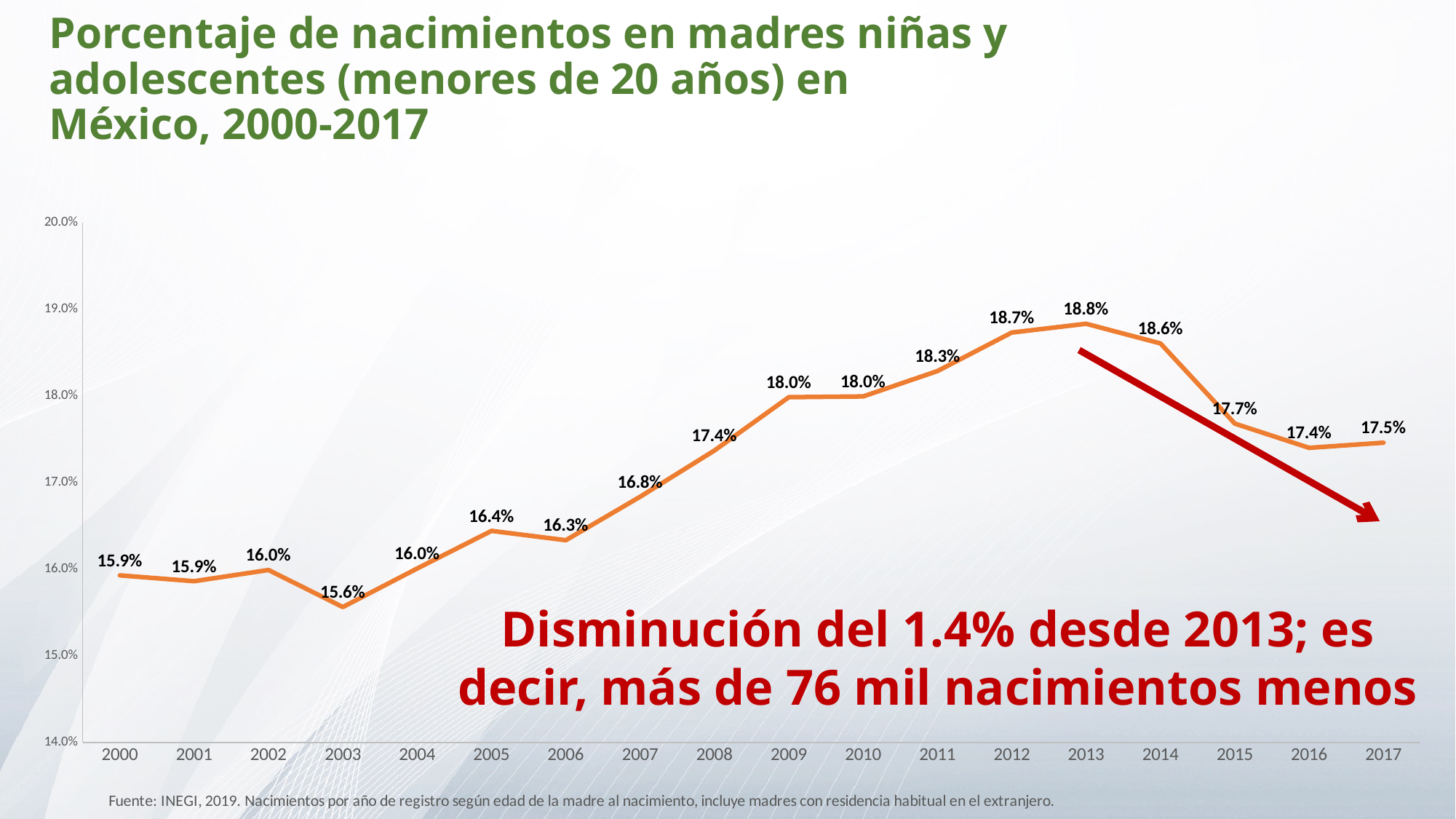
Do the values rise or fall from 2013 to 2017? fall How many years are plotted on the x axis? 18 What is the value for 2003? 15.6% What is the source cited at the bottom of the slide? INEGI, 2019 Is the value for 2009 greater or less than 17.0%? greater Which year has the lowest value? 2003 What is the difference between the values for 2013 and 2017? 1.3% What kind of chart is shown on the slide? line chart Which is larger, the value for 2012 or the value for 2014? 2012 What is the value for 2017? 17.5% Which year has the highest value? 2013 What is the value for 2013? 18.8%